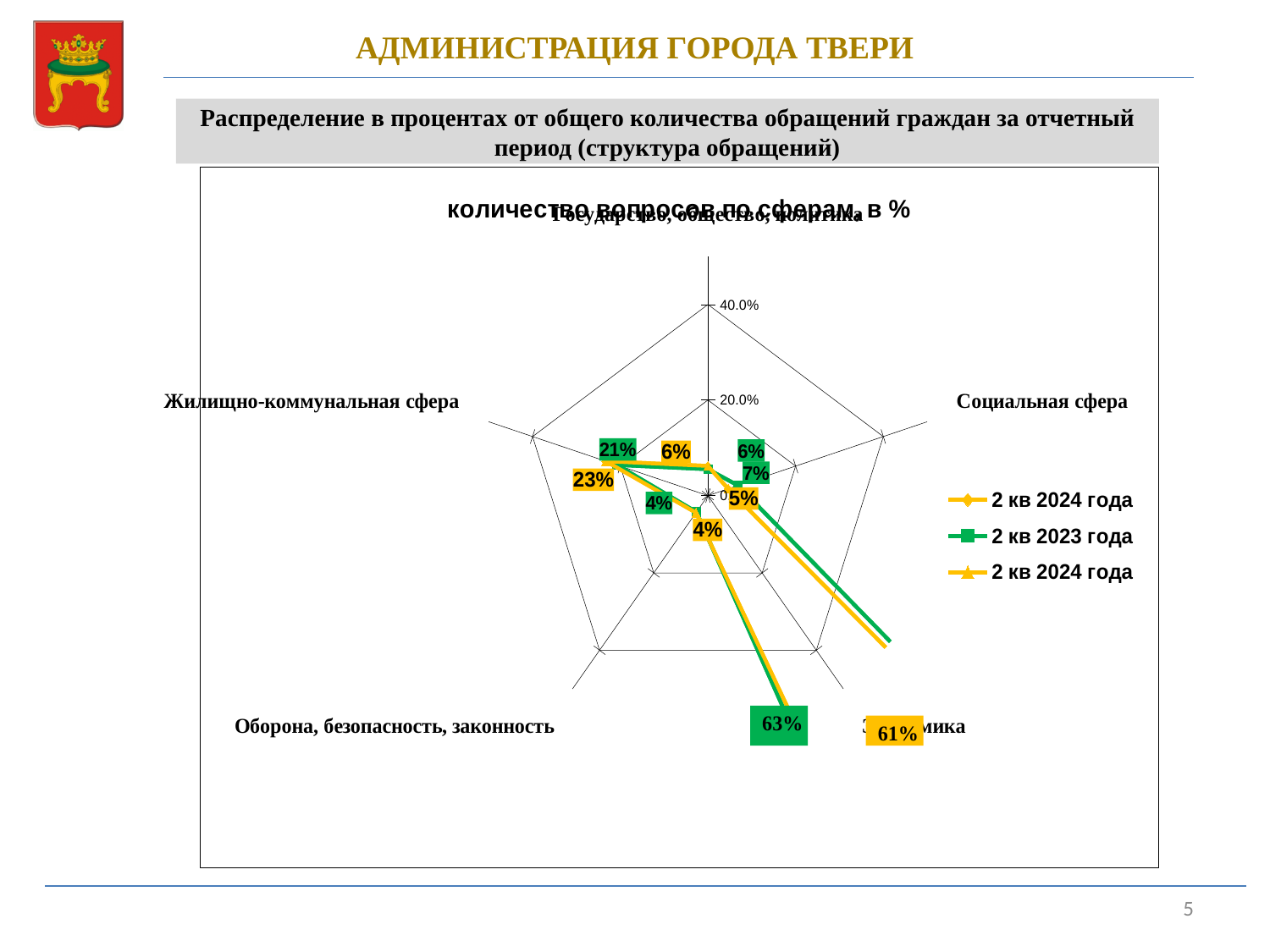
For Социальная сфера, which series has the larger value, 2 кв 2023 года or 2 кв 2024 года? 2 кв 2023 года How many categories (axes) does the radar chart have? 5 What is the value for Жилищно-коммунальная сфера in the 2 кв 2023 года series? 21% How many entries does the chart legend list? 3 What is the value for Оборона, безопасность, законность in the 2 кв 2024 года series? 4% What kind of chart is shown on the slide? Radar chart What is the value for Государство, общество, политика in the 2 кв 2023 года series? 6% By how many percentage points does the 2 кв 2024 года value for Жилищно-коммунальная сфера exceed the 2 кв 2023 года value? 2 percentage points What is the value for Жилищно-коммунальная сфера in the 2 кв 2024 года series? 23% What is the value for Социальная сфера in the 2 кв 2023 года series? 7% What is the title of the chart? количество вопросов по сферам, в % What is the value for Социальная сфера in the 2 кв 2024 года series? 5%